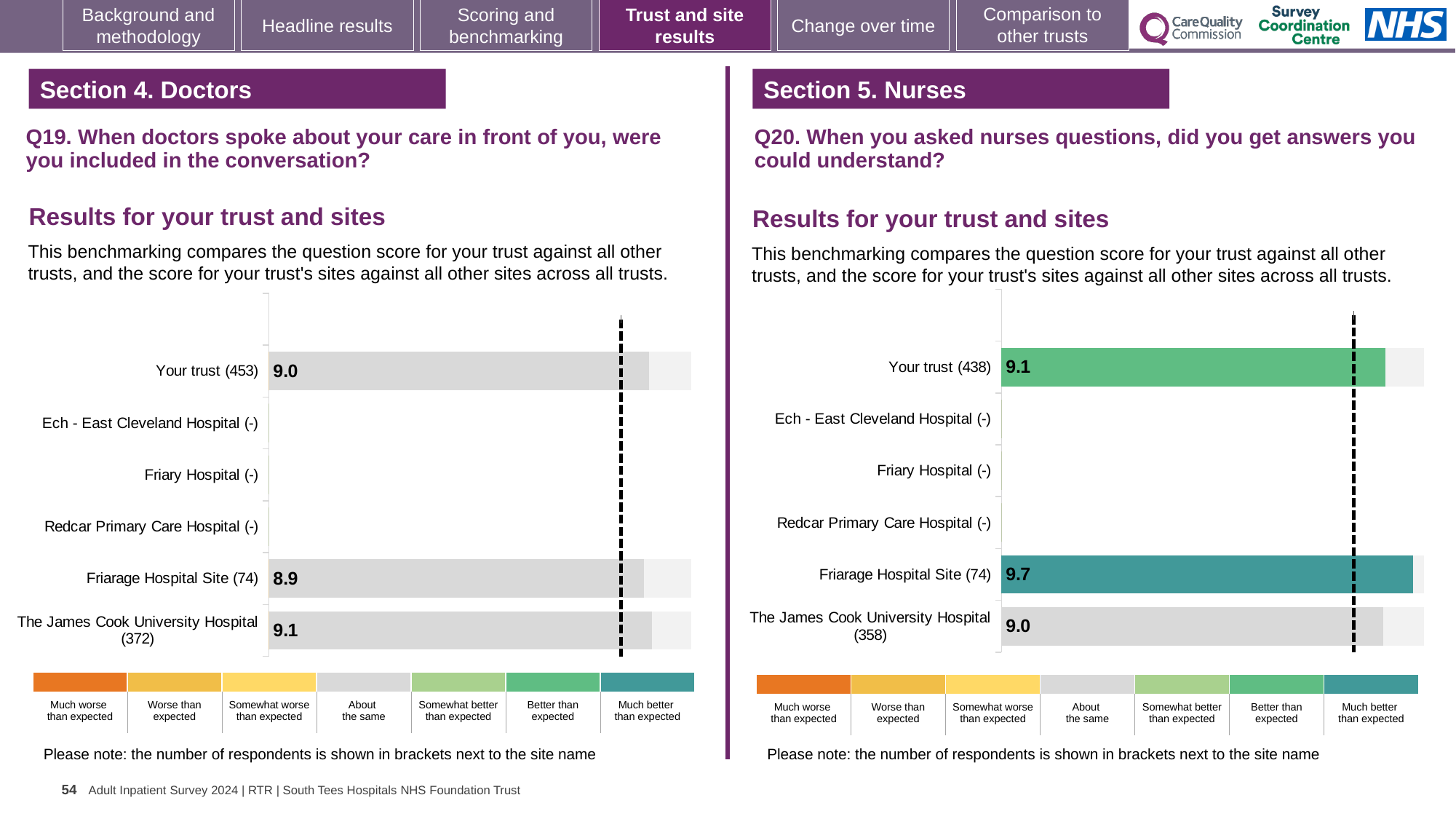
On the Q20 chart (right), what is the score for The James Cook University Hospital (358)? 9.0 On the Q19 chart (left), what is the score for Friarage Hospital Site (74)? 8.9 On the Q19 chart (left), what is the score for The James Cook University Hospital (372)? 9.1 On the Q19 chart (left), what is the score for Your trust (453)? 9.0 On the Q20 chart (right), what is the score for Your trust (438)? 9.1 On the Q19 chart (left), which site with a printed score has the lowest score? Friarage Hospital Site (74) What kind of chart is used on the Q20 chart (right)? Bar chart On the Q19 chart (left), which has the larger score: Friarage Hospital Site (74) or The James Cook University Hospital (372)? The James Cook University Hospital (372) On the Q20 chart (right), what is the difference between the scores for Friarage Hospital Site (74) and The James Cook University Hospital (358)? 0.7 On the Q20 chart (right), what is the score for Friarage Hospital Site (74)? 9.7 How many site rows (excluding Your trust) are listed on the Q19 chart (left)? 5 On the Q20 chart (right), which site has the highest score? Friarage Hospital Site (74)